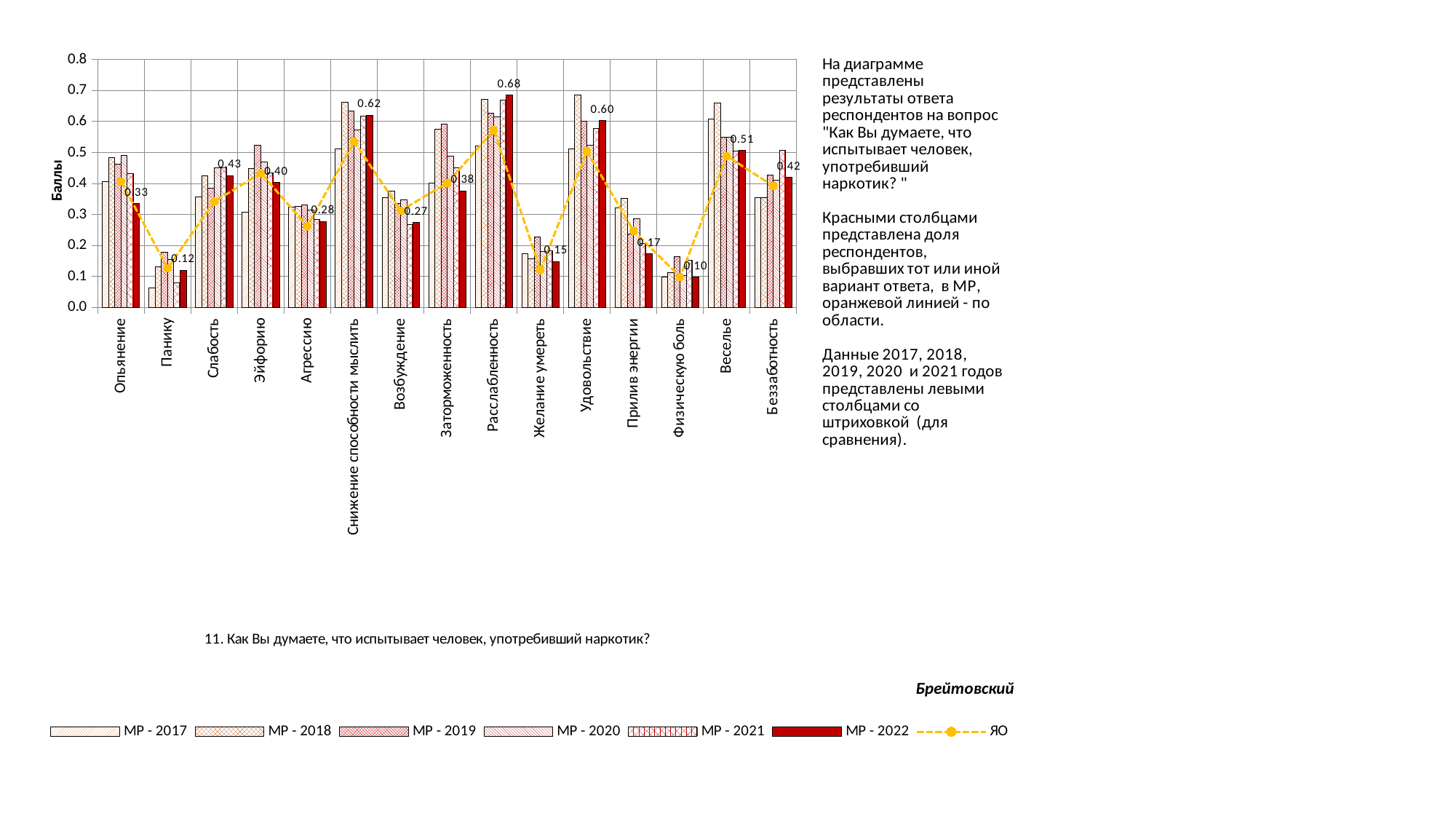
How many categories are shown on the x axis? 15 Which category has the highest ЯО value? Расслабленность How many series does the legend list? 7 Which category has the lowest ЯО value? Физическую боль Is the МР - 2022 value for Панику greater or less than 0.2? less Is the МР - 2022 value for Расслабленность greater or less than 0.6? greater What kind of chart is shown on the slide? Combined bar and line chart